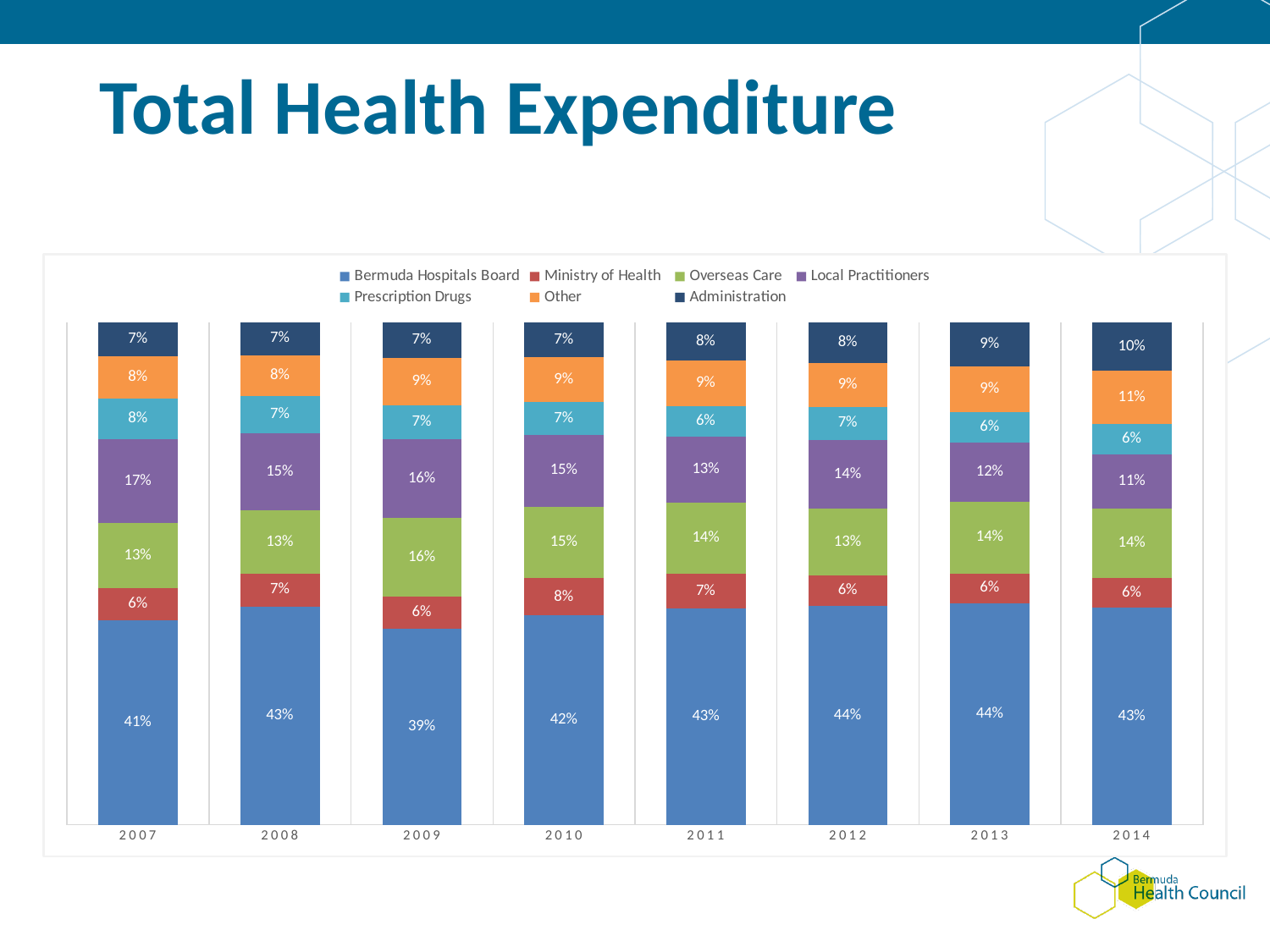
In which year was the Bermuda Hospitals Board share of expenditure lowest? 2009 What was the Local Practitioners share of total health expenditure in 2007? 17% What was the Administration share of total health expenditure in 2014? 10% Which was larger in 2014, the Other share or the Local Practitioners share? They are equal (11%) How many series does the legend list? 7 What percentage of total health expenditure went to the Bermuda Hospitals Board in 2009? 39% What was the Overseas Care share in 2009? 16% How many years are shown on the x axis of the chart? 8 In which year was the Local Practitioners share highest? 2007 How much larger was the Bermuda Hospitals Board share in 2013 than in 2009? 5% What kind of chart is shown on the slide? Stacked bar chart Does the Administration share rise or fall from 2007 to 2014? Rise